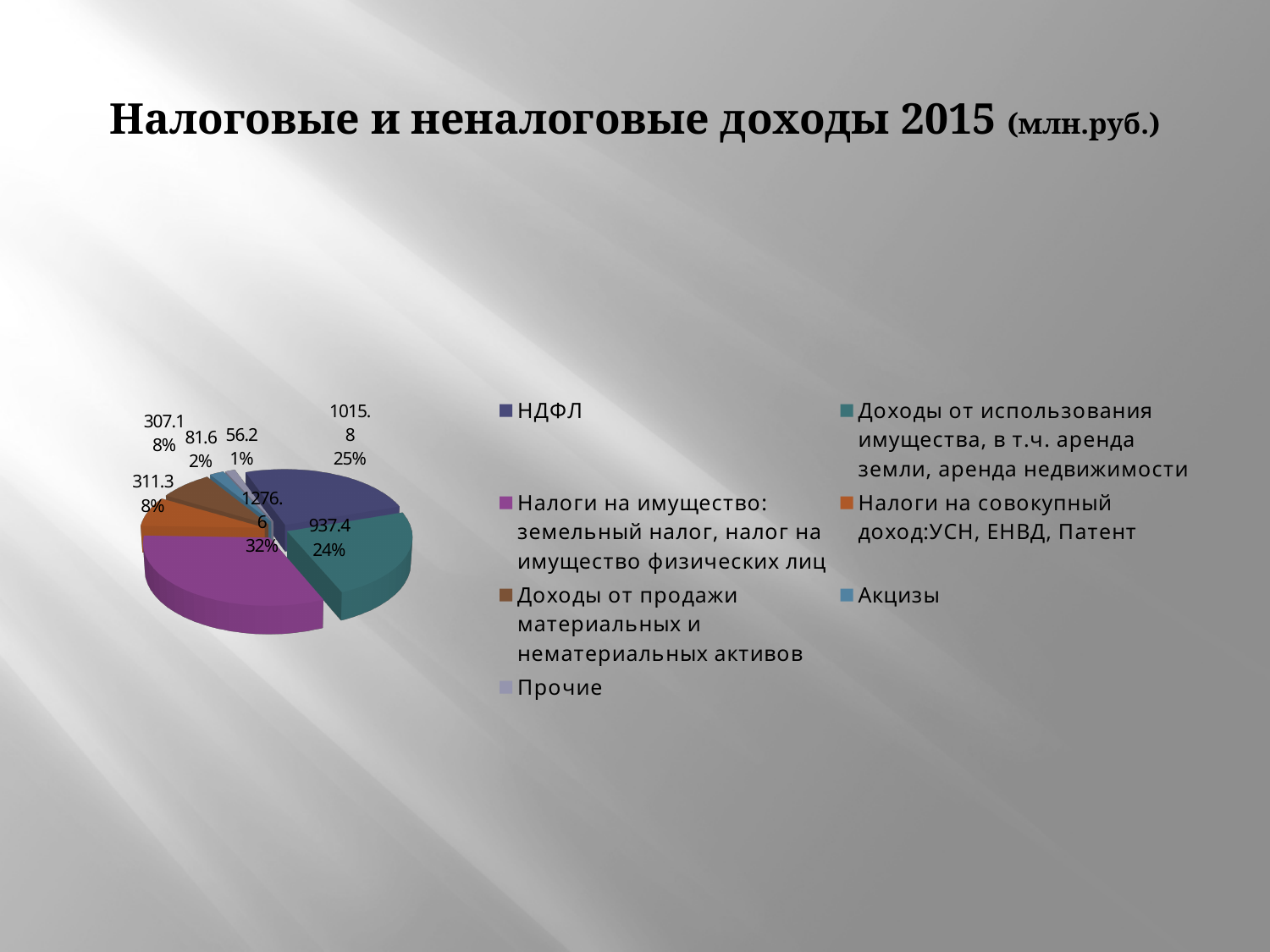
How many categories (slices) does the pie chart have? 7 What is the difference between the values for Налоги на имущество and НДФЛ? 260.8 What type of chart is shown on the slide? pie chart What is the value for НДФЛ? 1015.8 Which is larger, the value for Налоги на совокупный доход:УСН, ЕНВД, Патент or the value for Акцизы? Налоги на совокупный доход:УСН, ЕНВД, Патент What is the title of the chart? Налоговые и неналоговые доходы 2015 (млн.руб.) Which category has the largest slice of the pie? Налоги на имущество: земельный налог, налог на имущество физических лиц What is the value for Налоги на имущество: земельный налог, налог на имущество физических лиц? 1276.6 Which category has the smallest slice of the pie? Прочие What share of the pie does Прочие represent? 1% What share of the pie does Доходы от использования имущества, в т.ч. аренда земли, аренда недвижимости represent? 24% What is the value for Акцизы? 81.6